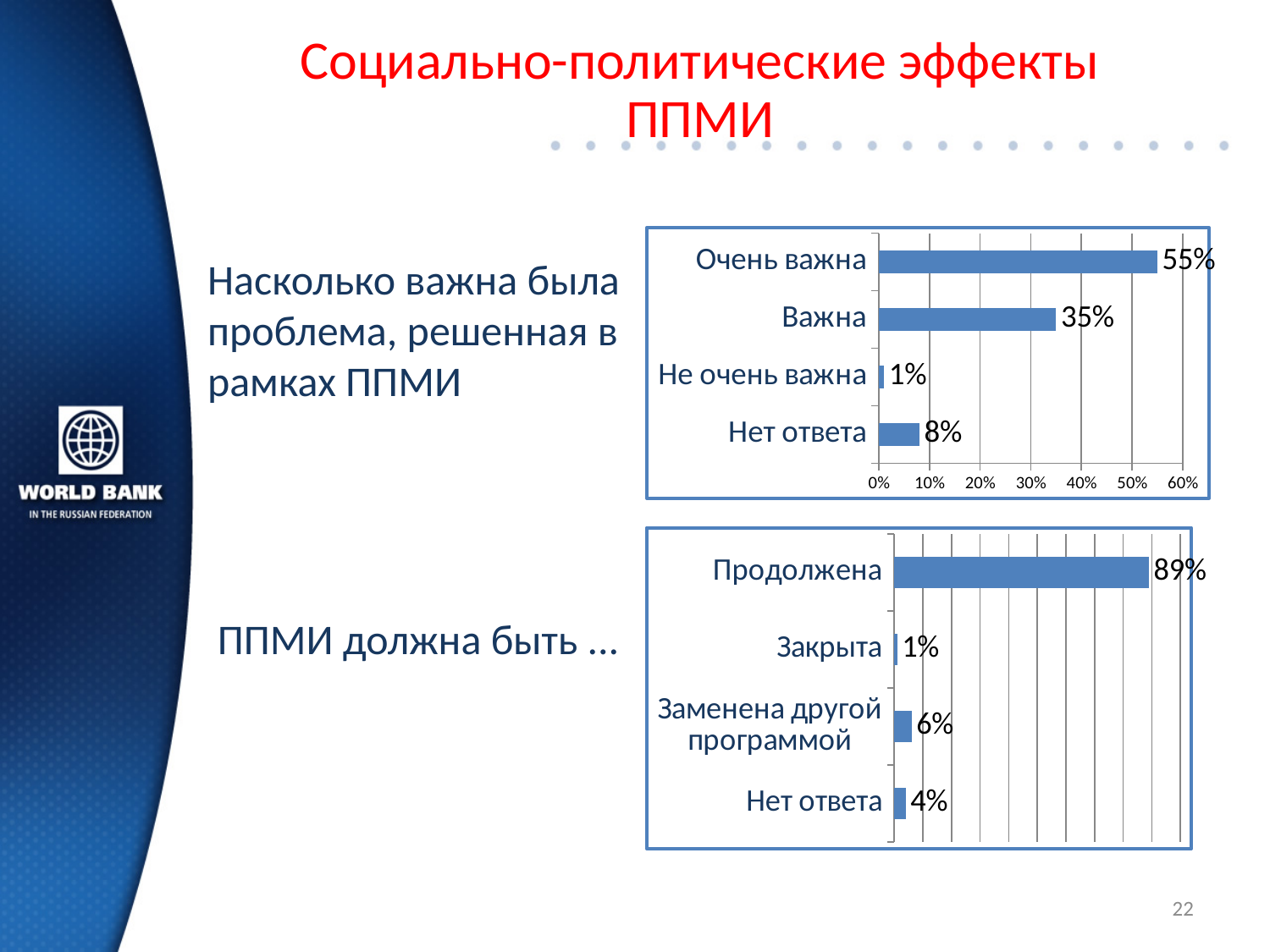
In the top chart, what is the difference between 'Очень важна' and 'Важна'? 20% In the bottom chart, which category has the highest value? Продолжена In the top chart (Насколько важна была проблема, решенная в рамках ППМИ), what is the value for 'Очень важна'? 55% In the top chart, is the value for 'Нет ответа' greater or less than 10%? less In the top chart, what is the value for 'Важна'? 35% In the bottom chart, which is larger: 'Заменена другой программой' or 'Нет ответа'? Заменена другой программой In the bottom chart, what is the value for 'Заменена другой программой'? 6% What type of chart is the bottom chart? Bar chart In the bottom chart (ППМИ должна быть ...), what is the value for 'Продолжена'? 89% In the top chart, which category has the lowest value? Не очень важна In the bottom chart, what is the difference between 'Продолжена' and 'Закрыта'? 88% In the top chart, how many categories are shown? 4